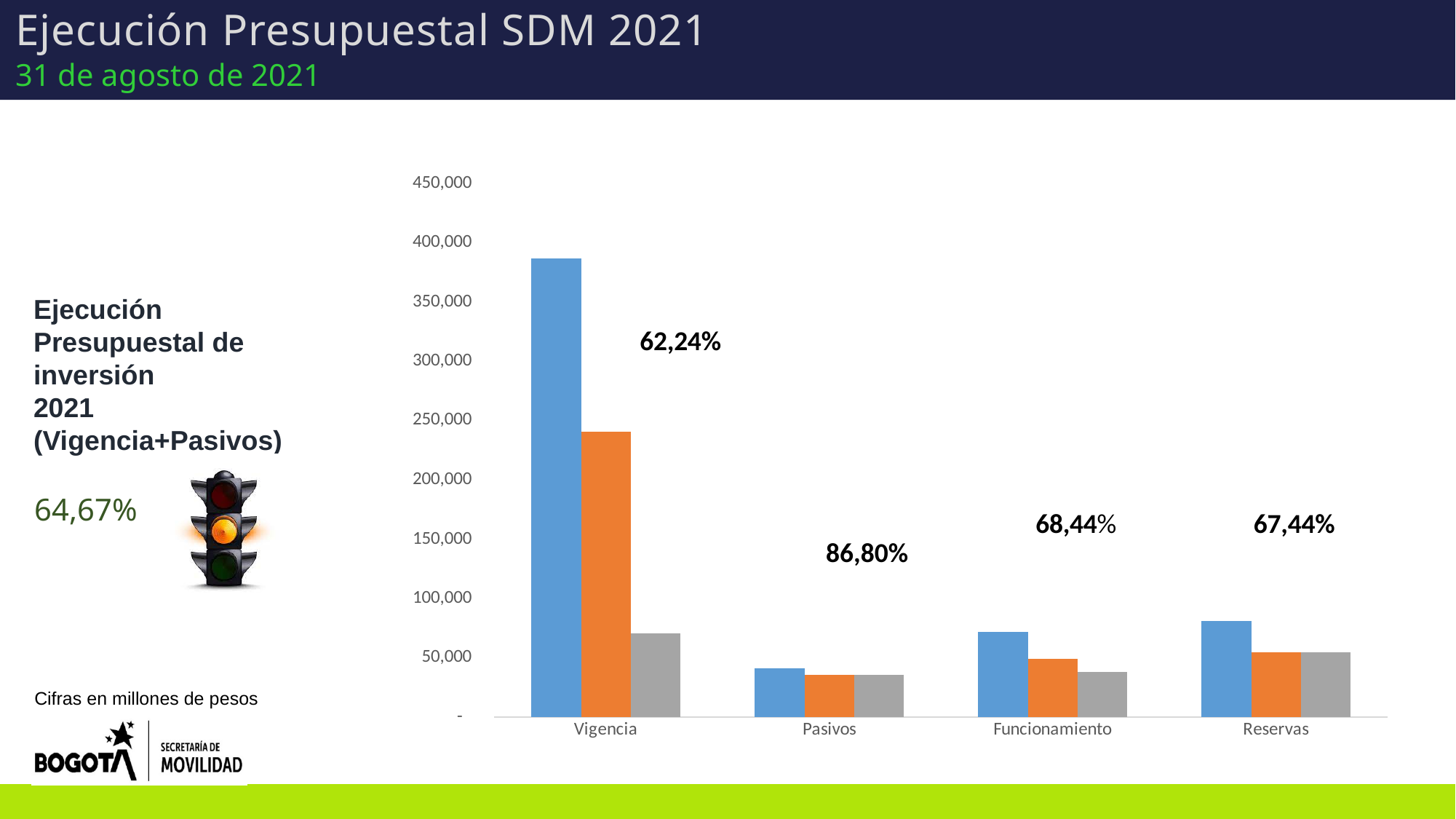
What percentage label is shown above the Pasivos group? 86,80% Which category has the lowest percentage label? Vigencia Is the value of the blue bar for Pasivos greater or less than 50,000? less Which category has the highest percentage label? Pasivos What percentage label is shown above the Reservas group? 67,44% What percentage label is shown above the Funcionamiento group? 68,44% Is the value of the blue bar for Vigencia greater or less than 350,000? greater What percentage label is shown above the Vigencia group? 62,24% Which category has the tallest bar in the chart? Vigencia What is the difference between the percentage labels for Pasivos and Vigencia? 24,56% What kind of chart is shown on the slide? bar chart How many categories are shown on the x axis of the chart? 4